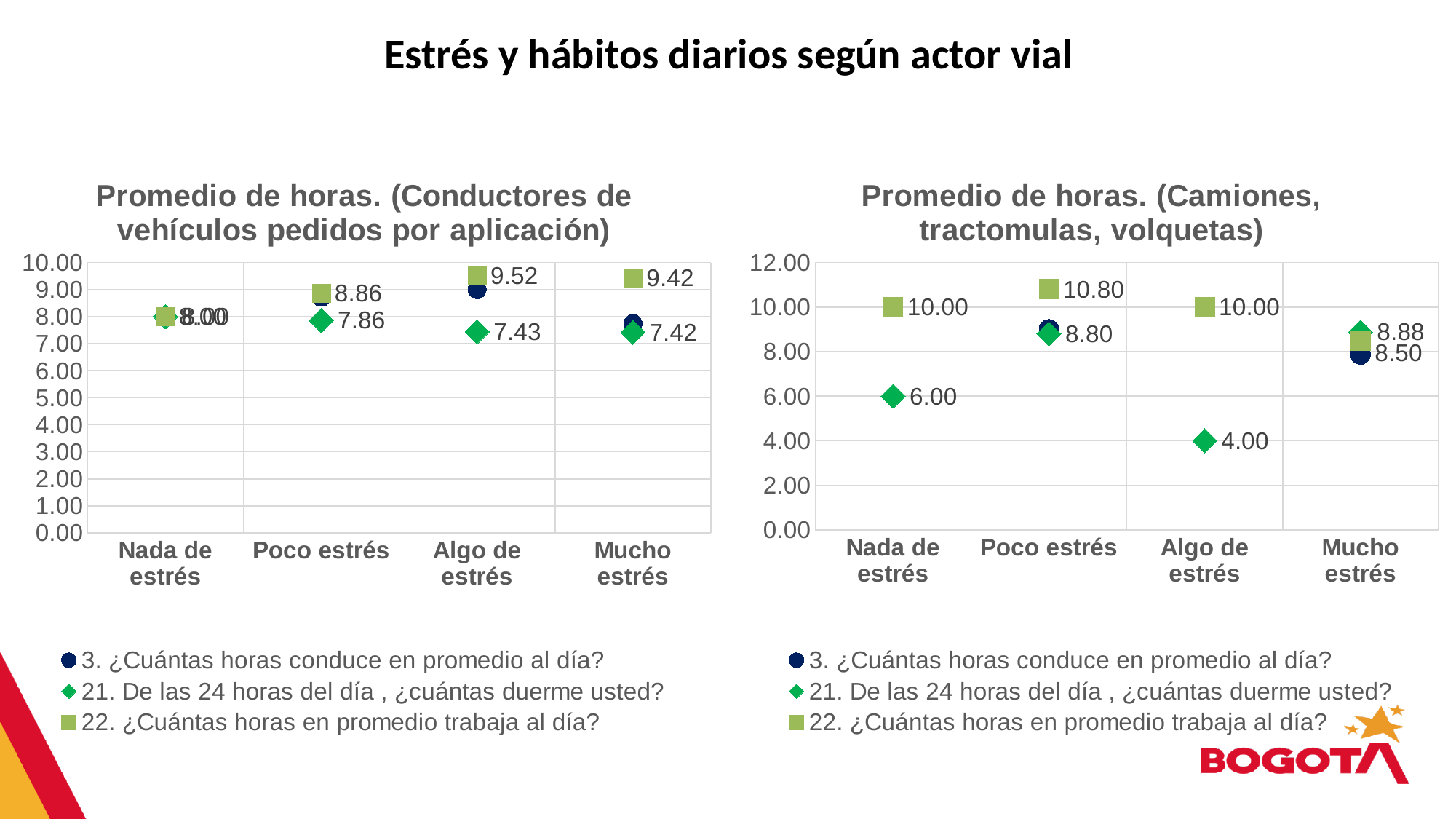
In the right chart, 'Promedio de horas. (Camiones, tractomulas, volquetas)', which category has the highest value for '22. ¿Cuántas horas en promedio trabaja al día?'? Poco estrés How many series does the legend of the right chart, 'Promedio de horas. (Camiones, tractomulas, volquetas)', list? 3 In the left chart, 'Promedio de horas. (Conductores de vehículos pedidos por aplicación)', what is the difference at 'Algo de estrés' between the hours worked (9.52) and the hours slept (7.43)? 2.09 In the left chart, 'Promedio de horas. (Conductores de vehículos pedidos por aplicación)', what is the value for '22. ¿Cuántas horas en promedio trabaja al día?' at 'Algo de estrés'? 9.52 In the left chart, 'Promedio de horas. (Conductores de vehículos pedidos por aplicación)', what is the value for '21. De las 24 horas del día, ¿cuántas duerme usted?' at 'Poco estrés'? 7.86 How many stress categories are shown on the x axis of the left chart, 'Promedio de horas. (Conductores de vehículos pedidos por aplicación)'? 4 In the right chart, 'Promedio de horas. (Camiones, tractomulas, volquetas)', what is the value for '21. De las 24 horas del día, ¿cuántas duerme usted?' at 'Algo de estrés'? 4.00 In the right chart, 'Promedio de horas. (Camiones, tractomulas, volquetas)', what is the value for '22. ¿Cuántas horas en promedio trabaja al día?' at 'Poco estrés'? 10.80 In the left chart, 'Promedio de horas. (Conductores de vehículos pedidos por aplicación)', is the value for '3. ¿Cuántas horas conduce en promedio al día?' at 'Algo de estrés' greater or less than 8.00? greater What kind of chart is the left chart, 'Promedio de horas. (Conductores de vehículos pedidos por aplicación)'? scatter chart In the right chart, 'Promedio de horas. (Camiones, tractomulas, volquetas)', which category has the lowest value for '21. De las 24 horas del día, ¿cuántas duerme usted?'? Algo de estrés